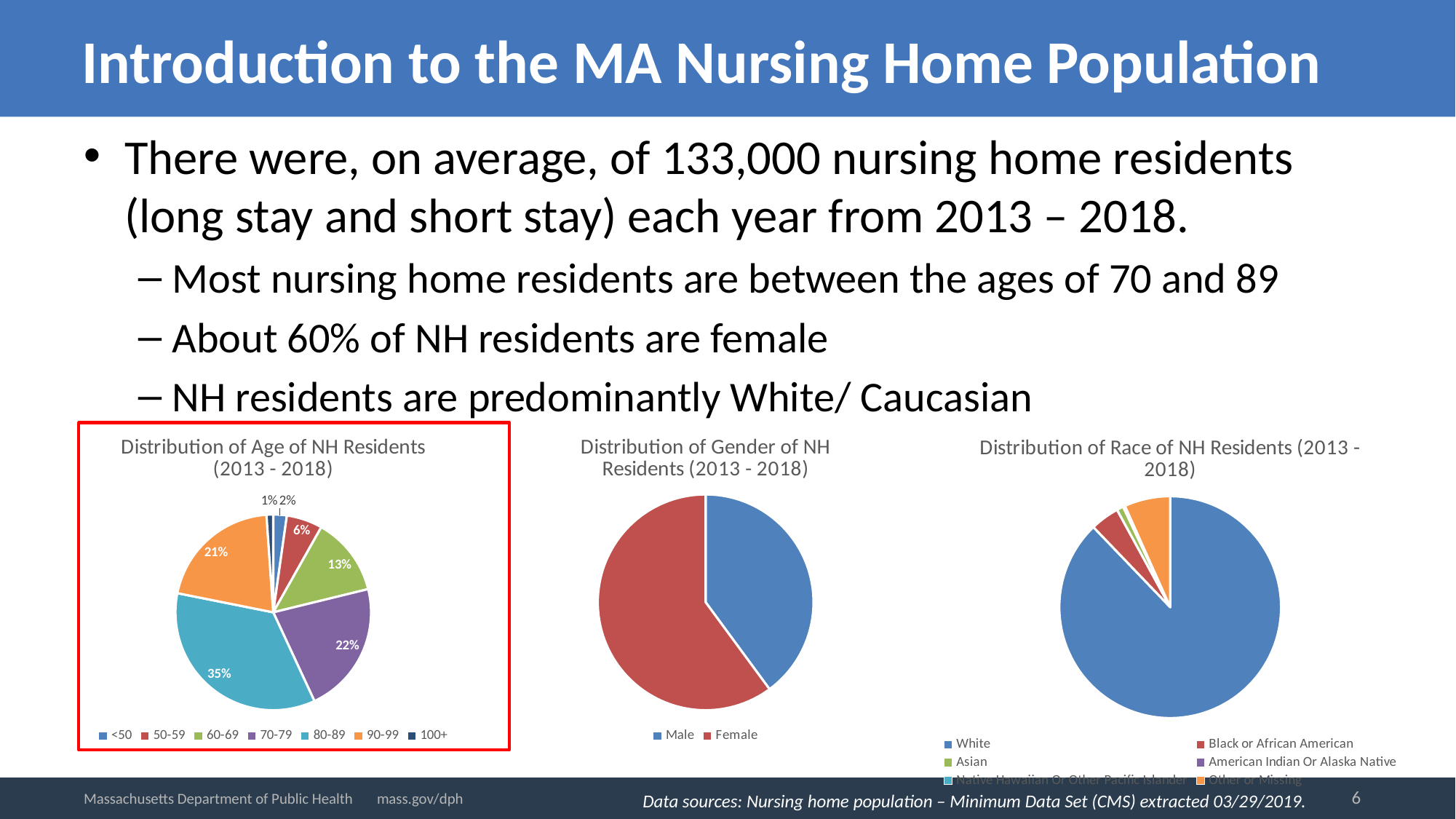
In the 'Distribution of Age of NH Residents (2013 - 2018)' chart, what percentage of residents are aged 90-99? 21% In the 'Distribution of Gender of NH Residents (2013 - 2018)' chart, which gender has the larger share? Female In the 'Distribution of Age of NH Residents (2013 - 2018)' chart, what percentage of residents are aged 70-79? 22% In the 'Distribution of Age of NH Residents (2013 - 2018)' chart, which age group has the smallest share? 100+ In the 'Distribution of Age of NH Residents (2013 - 2018)' chart, what percentage of residents are aged 60-69? 13% In the 'Distribution of Age of NH Residents (2013 - 2018)' chart, what is the difference in percentage points between the 80-89 and 70-79 groups? 13 In the 'Distribution of Age of NH Residents (2013 - 2018)' chart, which group has a larger share, 60-69 or 90-99? 90-99 In the 'Distribution of Age of NH Residents (2013 - 2018)' chart, what percentage of residents are aged 80-89? 35% What type of chart is the 'Distribution of Gender of NH Residents (2013 - 2018)' chart? Pie chart In the 'Distribution of Age of NH Residents (2013 - 2018)' chart, which age group has the largest share? 80-89 In the 'Distribution of Race of NH Residents (2013 - 2018)' chart, which race category has the largest share? White How many age groups are shown in the 'Distribution of Age of NH Residents (2013 - 2018)' chart? 7